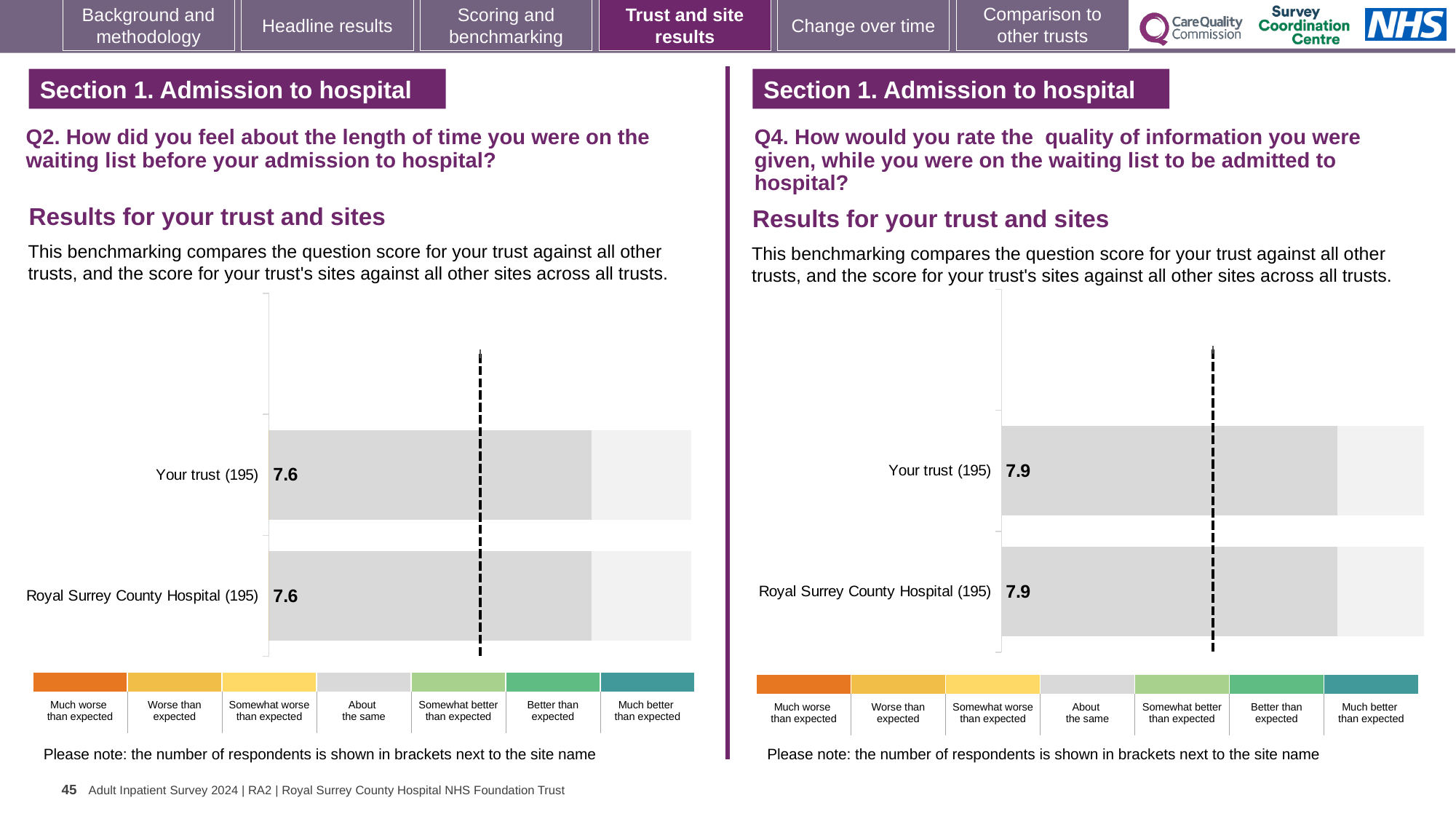
In the Q2 chart on the left, how many respondents are shown in brackets next to Your trust? 195 What type of chart is used for the Q2 results on the left? Bar chart How many rating categories does the colour key below the Q4 chart on the right list? 7 How many bars are plotted in the Q2 chart on the left? 2 In the Q2 chart on the left, what is the score for Royal Surrey County Hospital? 7.6 In the Q2 chart on the left, what is the difference between the score for Your trust and the score for Royal Surrey County Hospital? 0 In the Q4 chart on the right, what is the difference between the score for Your trust and the score for Royal Surrey County Hospital? 0 How many bars are plotted in the Q4 chart on the right? 2 In the Q2 chart on the left, what is the score for Your trust? 7.6 In the Q4 chart on the right, what is the score for Royal Surrey County Hospital? 7.9 In the Q2 chart on the left, which rating category does the grey band in the colour key represent? About the same In the Q4 chart on the right, what is the score for Your trust? 7.9